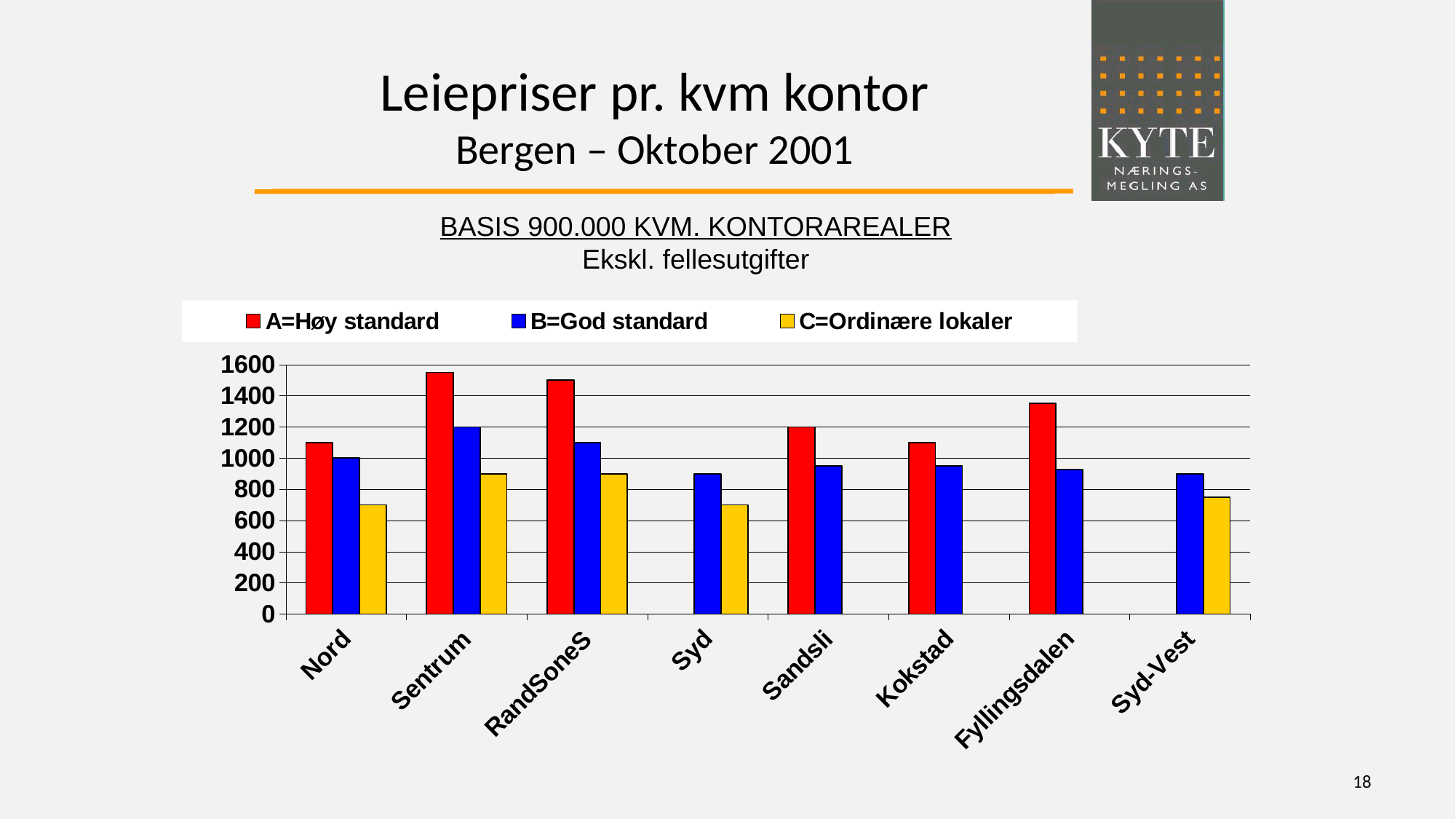
Is the A=Høy standard value for Sentrum greater or less than 1400? greater Which colour represents the C=Ordinære lokaler series? yellow Is the A=Høy standard value for Fyllingsdalen greater or less than 1200? greater Which district has the highest value for B=God standard? Sentrum Which district has the highest value for A=Høy standard? Sentrum How many series does the legend list? 3 What type of chart is shown on the slide? bar chart How many districts (categories) are shown on the x axis? 8 Which is larger, the A=Høy standard value for Nord or for Fyllingsdalen? Fyllingsdalen Which is larger, the C=Ordinære lokaler value for Sentrum or for Syd-Vest? Sentrum Is the B=God standard value for Syd greater or less than 1000? less